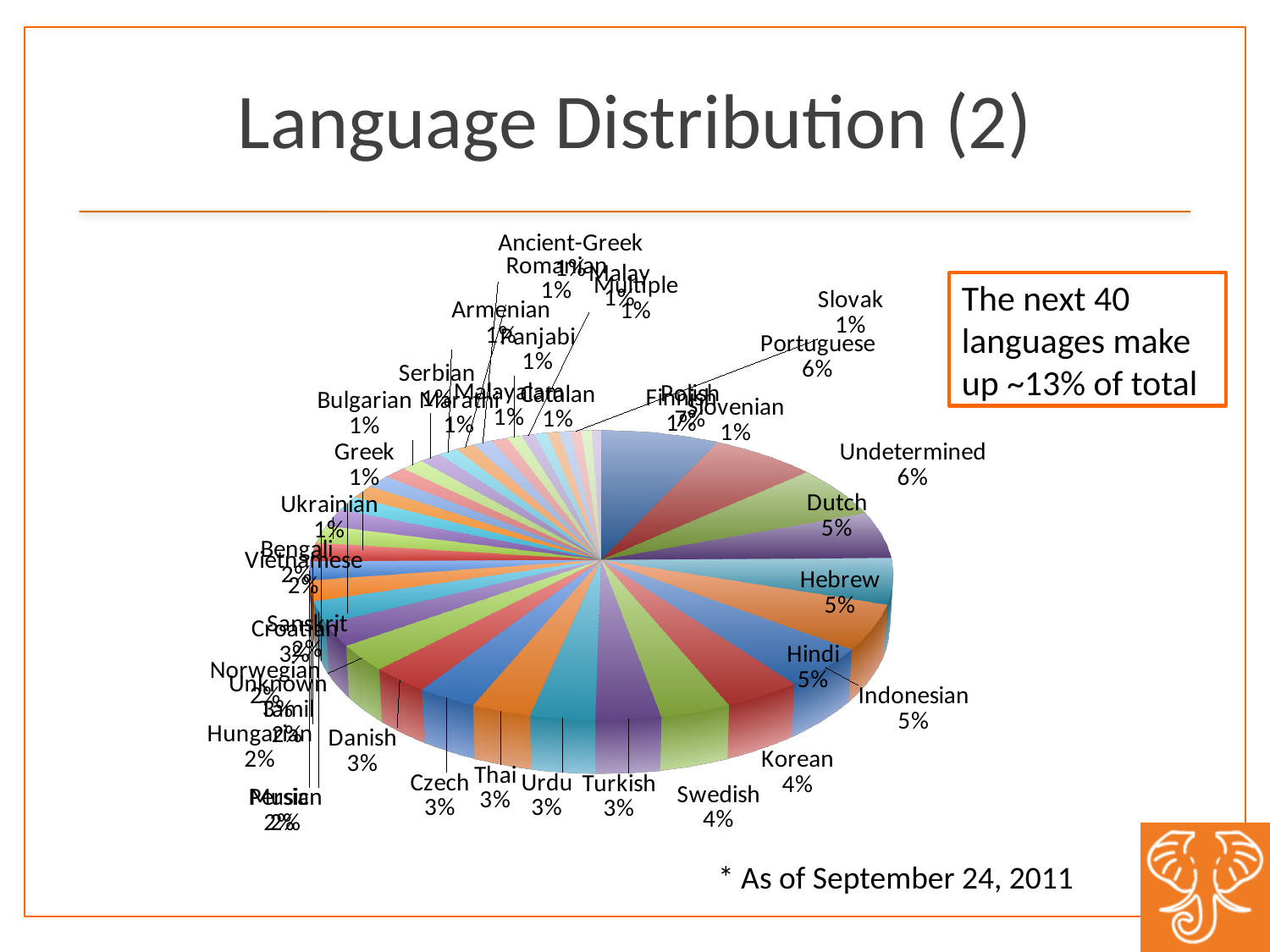
What kind of chart is shown on the slide? pie chart What percentage is shown for Swedish? 4% What percentage is shown for Slovak? 1% What is the title of the slide containing the pie chart? Language Distribution (2) Which has the larger share, Hebrew or Czech? Hebrew What is the difference between the shares of Portuguese and Korean? 2% What percentage is shown for Hungarian? 2% What share of the pie does Portuguese account for? 6% What percentage is shown for Dutch? 5% What is the value shown for Korean? 4% What is the value shown for Turkish? 3% What percentage is shown for Undetermined? 6%